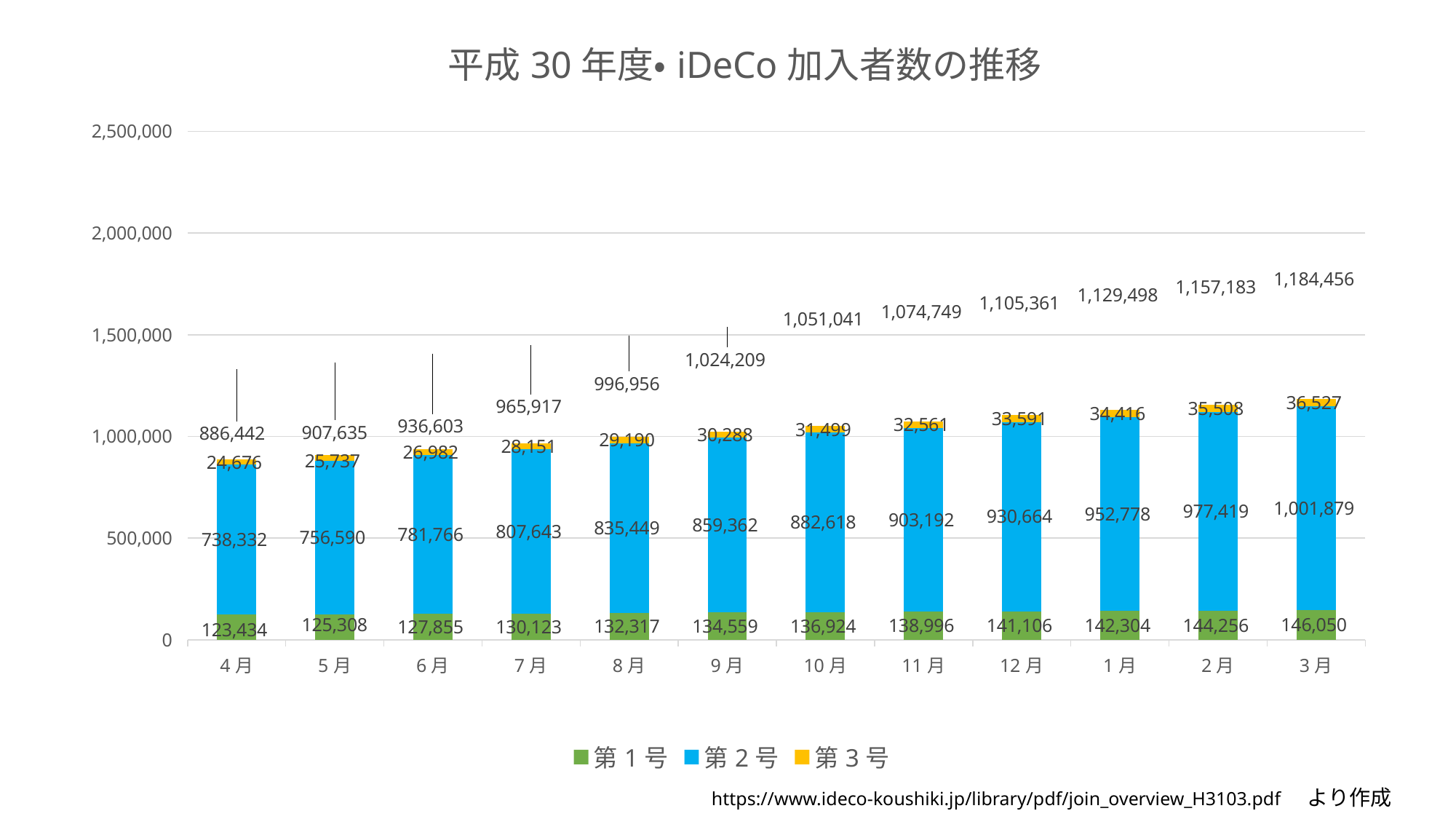
What type of chart is shown on the slide? stacked bar chart What is the value of 第1号 for 3月? 146,050 What is the title of the chart? 平成30年度・iDeCo加入者数の推移 How many months are shown on the x axis? 12 Which month has the lowest value for 第1号? 4月 Which month has the highest total? 3月 How many series does the legend list? 3 What is the value of 第3号 for 10月? 31,499 What is the total of the stacked bar for 9月? 1,024,209 What is the value of 第2号 for 4月? 738,332 Do the totals rise or fall from 4月 to 3月? rise What is the difference between the 第2号 values for 3月 and 4月? 263,547